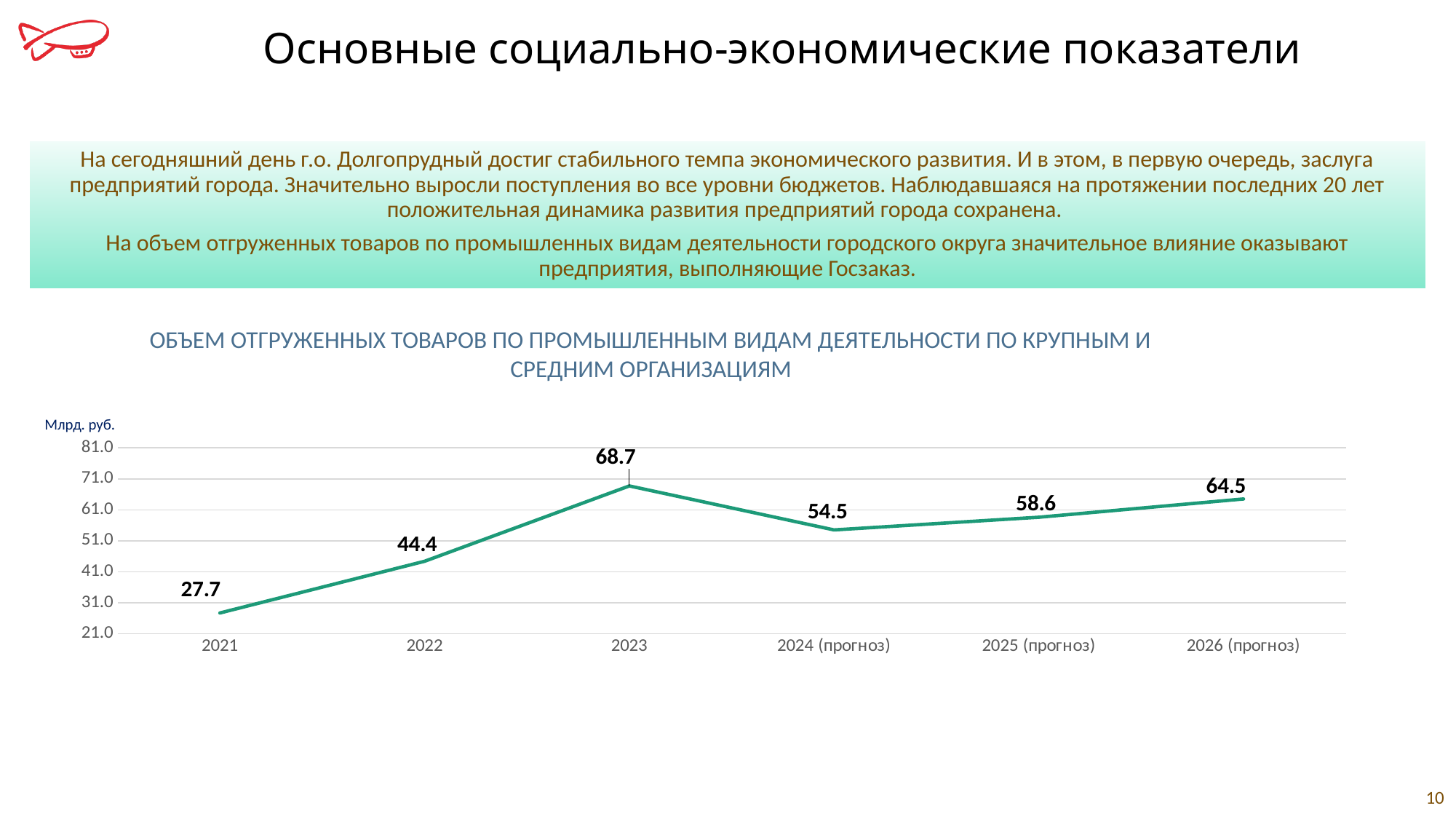
How many data points are plotted on the chart? 6 Which is larger, the value for 2025 (прогноз) or the value for 2024 (прогноз)? 2025 (прогноз) What kind of chart is shown on the slide? line chart What is the difference between the values for 2023 and 2024 (прогноз)? 14.2 What is the value for 2021? 27.7 What is the difference between the values for 2022 and 2021? 16.7 Is the value for 2022 greater or less than 41.0? greater What is the value for 2026 (прогноз)? 64.5 Which year has the highest value? 2023 Which year has the lowest value? 2021 What unit is shown on the y axis of the chart? Млрд. руб. What is the value for 2023? 68.7